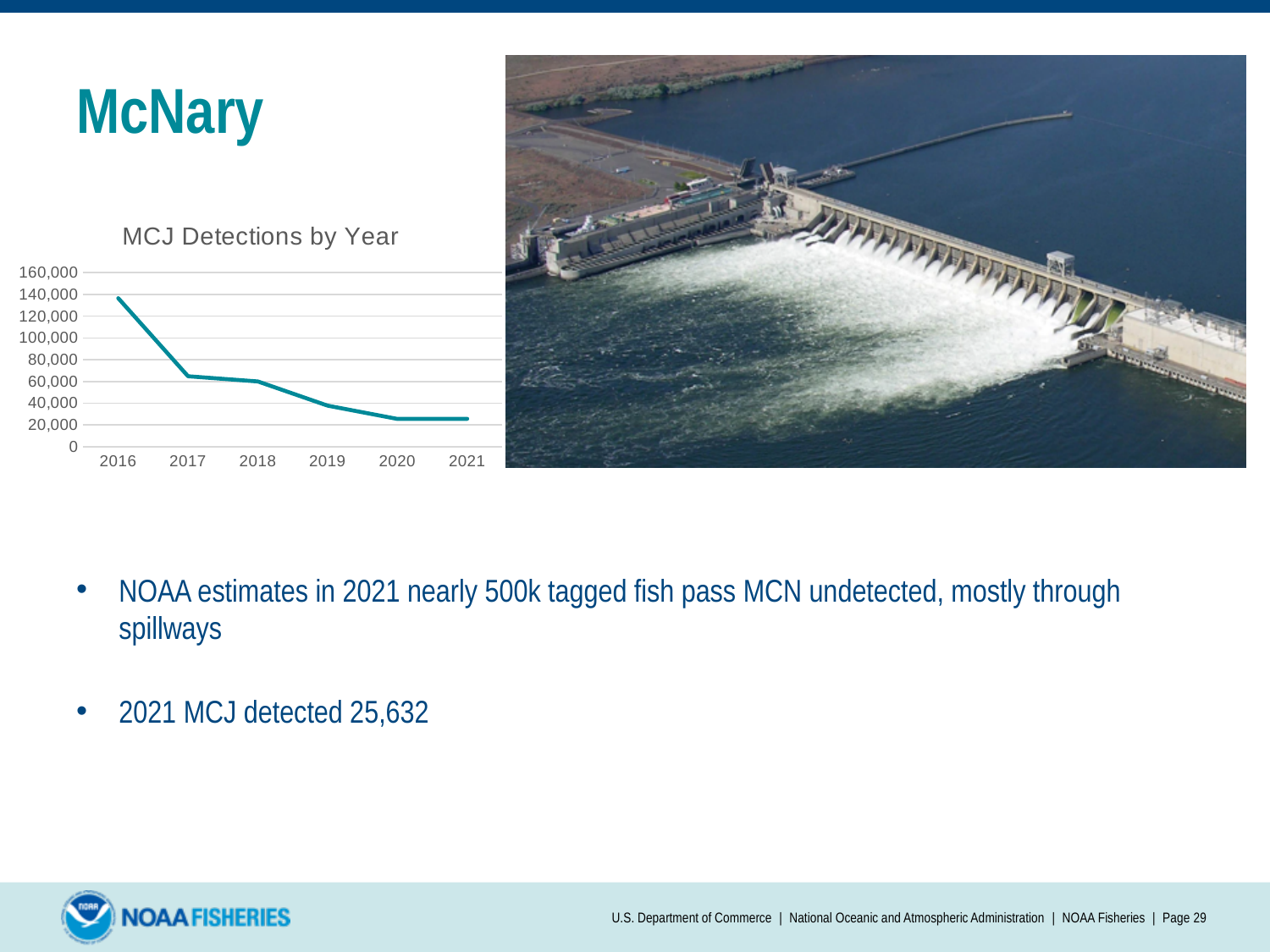
Is the value for 2019 greater or less than 60,000? less Is the value for 2017 greater or less than 80,000? less What kind of chart is shown on the slide? line chart According to the slide, how many fish did MCJ detect in 2021? 25,632 How many years are plotted on the x axis of the chart? 6 Do MCJ detections rise or fall from 2016 to 2021? fall What is the title of the chart? MCJ Detections by Year Is the value for 2016 greater or less than 120,000? greater Which year has more MCJ detections, 2017 or 2019? 2017 Which year has more MCJ detections, 2016 or 2017? 2016 Which year has the highest number of MCJ detections? 2016